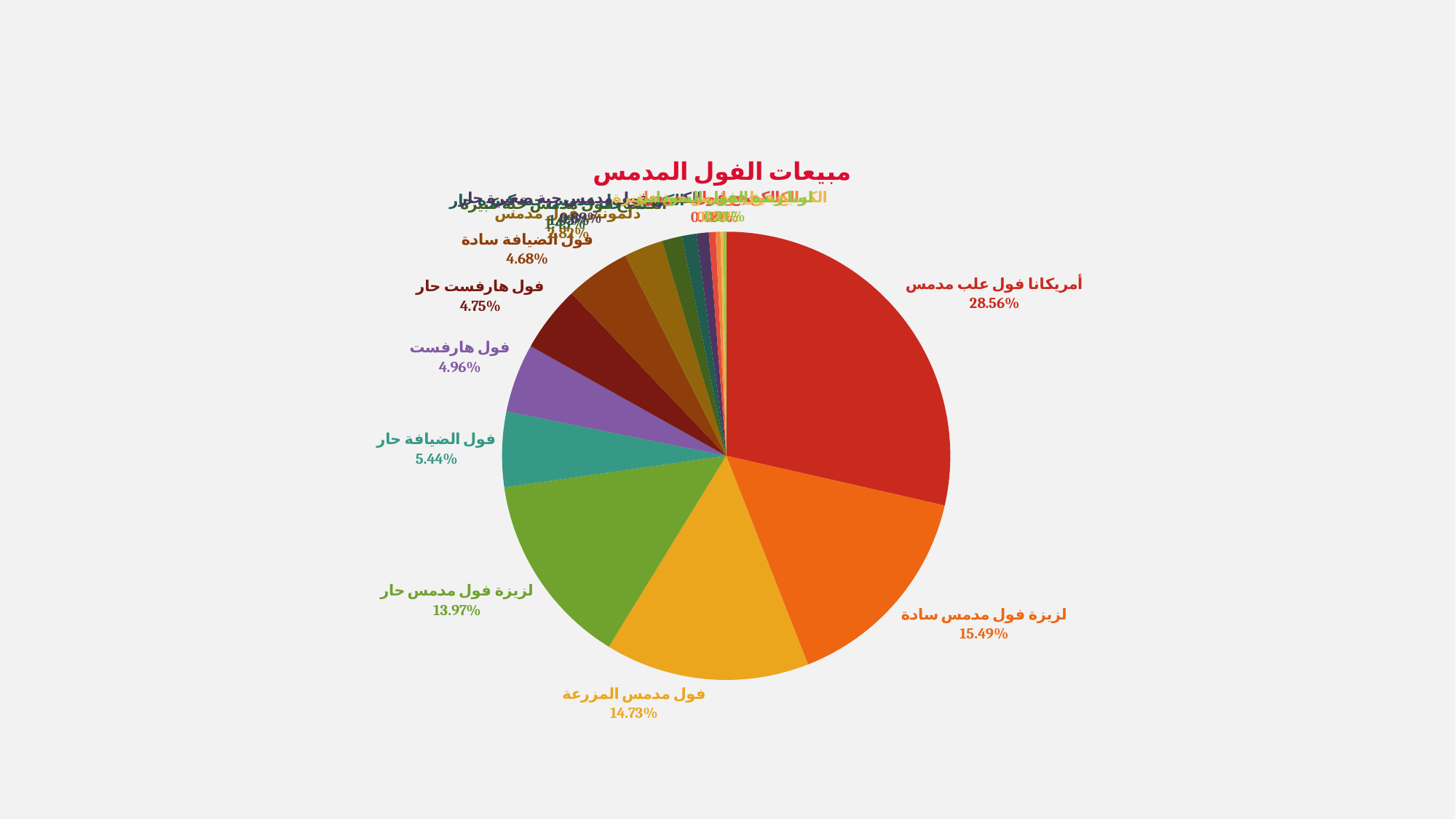
Which category has the largest slice of the pie? أمريكانا فول علب مدمس What is the difference between the shares of فول مدمس المزرعة and لزيزة فول مدمس حار? 0.76% What is the value shown for لزيزة فول مدمس سادة? 15.49% What kind of chart is shown on the slide? pie chart What is the value shown for فول مدمس المزرعة? 14.73% What is the difference between the shares of أمريكانا فول علب مدمس and لزيزة فول مدمس سادة? 13.07% What is the value shown for فول الضيافة حار? 5.44% What is the value shown for فول هارفست حار? 4.75% What share of the pie does أمريكانا فول علب مدمس have? 28.56% Which is larger, the share of فول الضيافة حار or the share of فول هارفست? فول الضيافة حار What is the value shown for لزيزة فول مدمس حار? 13.97% What is the title of the chart? مبيعات الفول المدمس